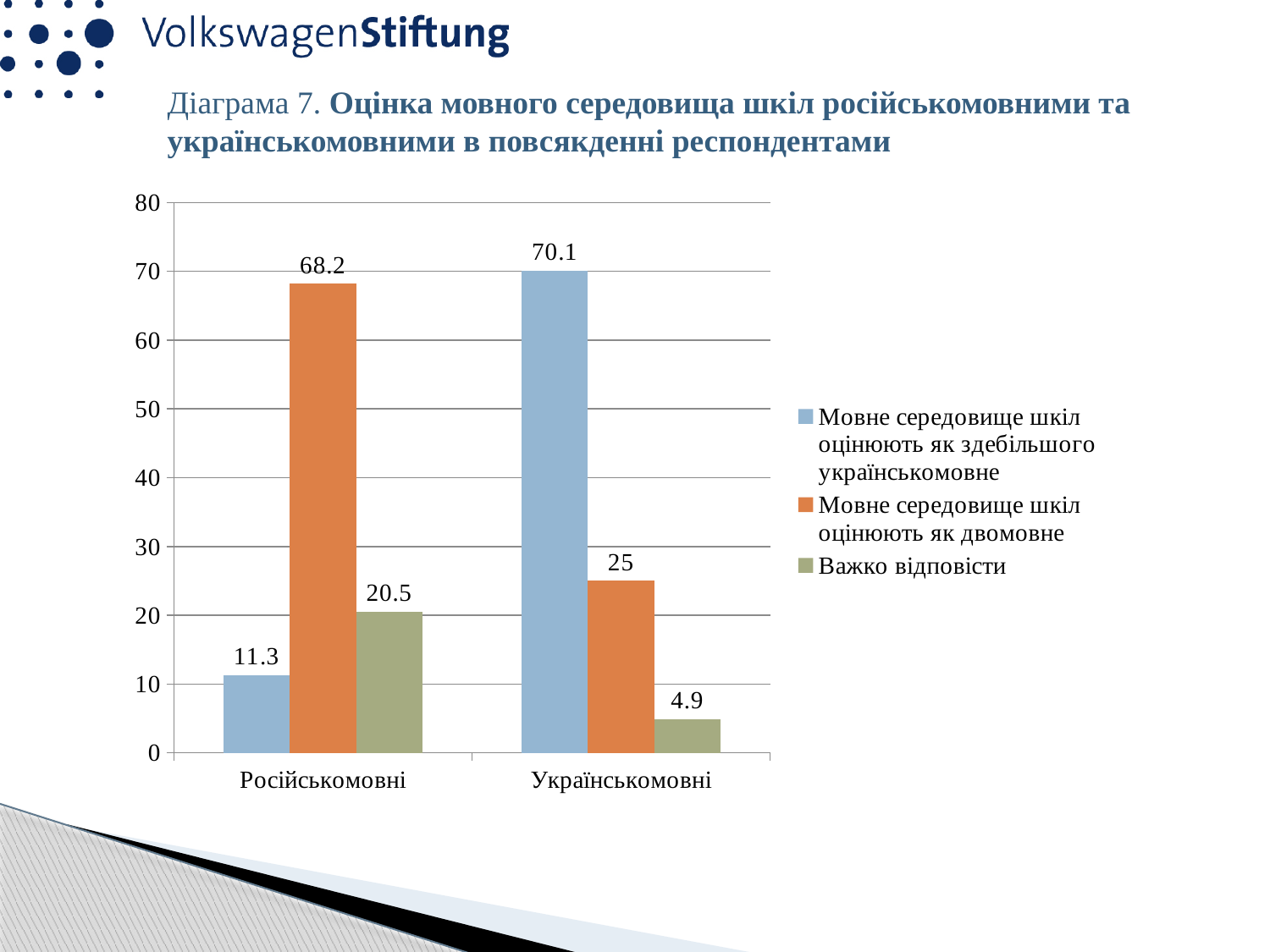
What value is shown for Російськомовні in the series 'Мовне середовище шкіл оцінюють як двомовне'? 68.2 Which series has the highest value for Українськомовні? Мовне середовище шкіл оцінюють як здебільшого українськомовне How many categories are shown on the x axis? 2 What value is shown for Українськомовні in the series 'Важко відповісти'? 4.9 What value is shown for Українськомовні in the series 'Мовне середовище шкіл оцінюють як здебільшого українськомовне'? 70.1 Which series has the lowest value for Російськомовні? Мовне середовище шкіл оцінюють як здебільшого українськомовне How many series does the legend list? 3 Which is larger: the 'Важко відповісти' value for Російськомовні or for Українськомовні? Російськомовні What is the difference between the 'Мовне середовище шкіл оцінюють як двомовне' values for Російськомовні and Українськомовні? 43.2 Is the value for Російськомовні in the series 'Мовне середовище шкіл оцінюють як здебільшого українськомовне' greater or less than 20? less What kind of chart is shown on the slide? bar chart What value is shown for Російськомовні in the series 'Важко відповісти'? 20.5